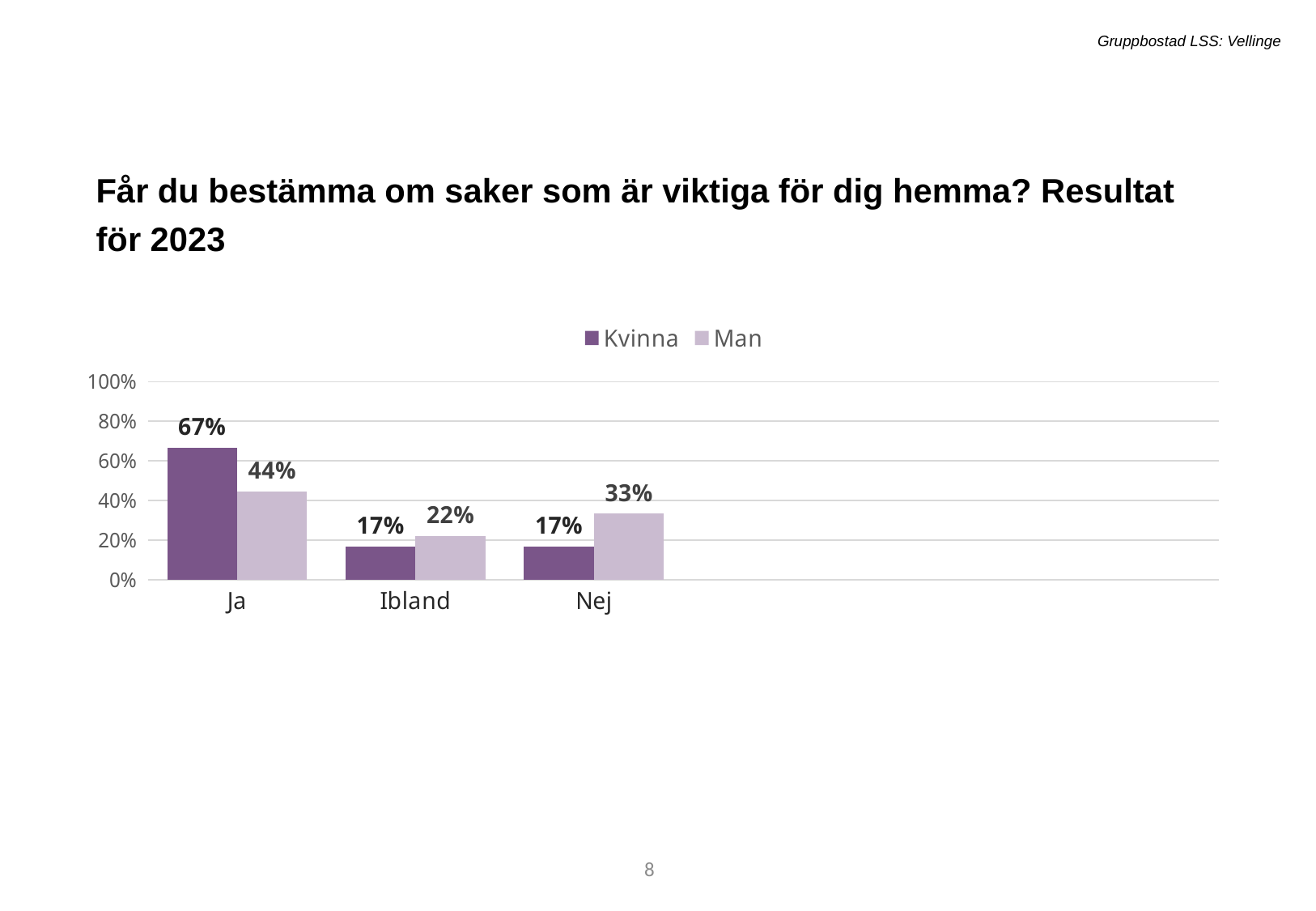
Which category has the highest value for the Kvinna series? Ja What is the difference between the Kvinna and Man values in the Ja category? 23% Is the value for Man in the Ja category greater or less than 40%? greater Which series is shown in the darker purple colour? Kvinna What is the value for Man in the Ibland category? 22% What kind of chart is shown on the slide? Bar chart What is the value for Kvinna in the Ja category? 67% What is the value for Man in the Nej category? 33% How many series does the legend list? 2 Which category has the lowest value for the Man series? Ibland How many categories are shown on the x axis? 3 In the Nej category, which series has the larger value, Kvinna or Man? Man